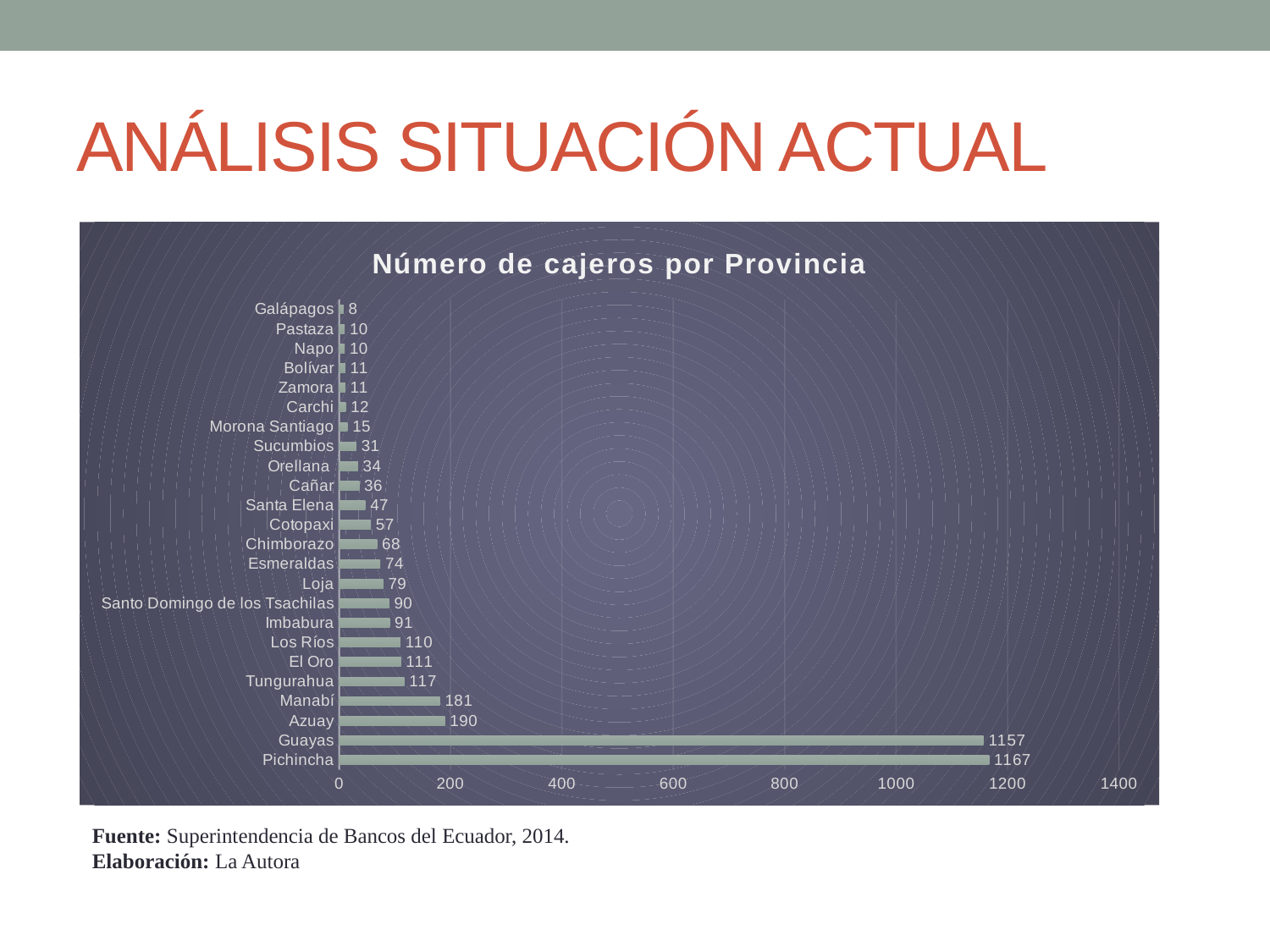
What type of chart is shown on the slide? bar chart Which has more cajeros, Tungurahua or El Oro? Tungurahua What is the difference between the values for Pichincha and Guayas? 10 Which province has the lowest number of cajeros? Galápagos What is the difference between the values for Azuay and Manabí? 9 Is the value for Azuay greater or less than 200? less Which province has the highest number of cajeros? Pichincha What is the title of the chart? Número de cajeros por Provincia What is the number of cajeros for Manabí? 181 What is the number of cajeros for Santo Domingo de los Tsachilas? 90 What is the number of cajeros for Guayas? 1157 How many provinces are shown in the chart? 24